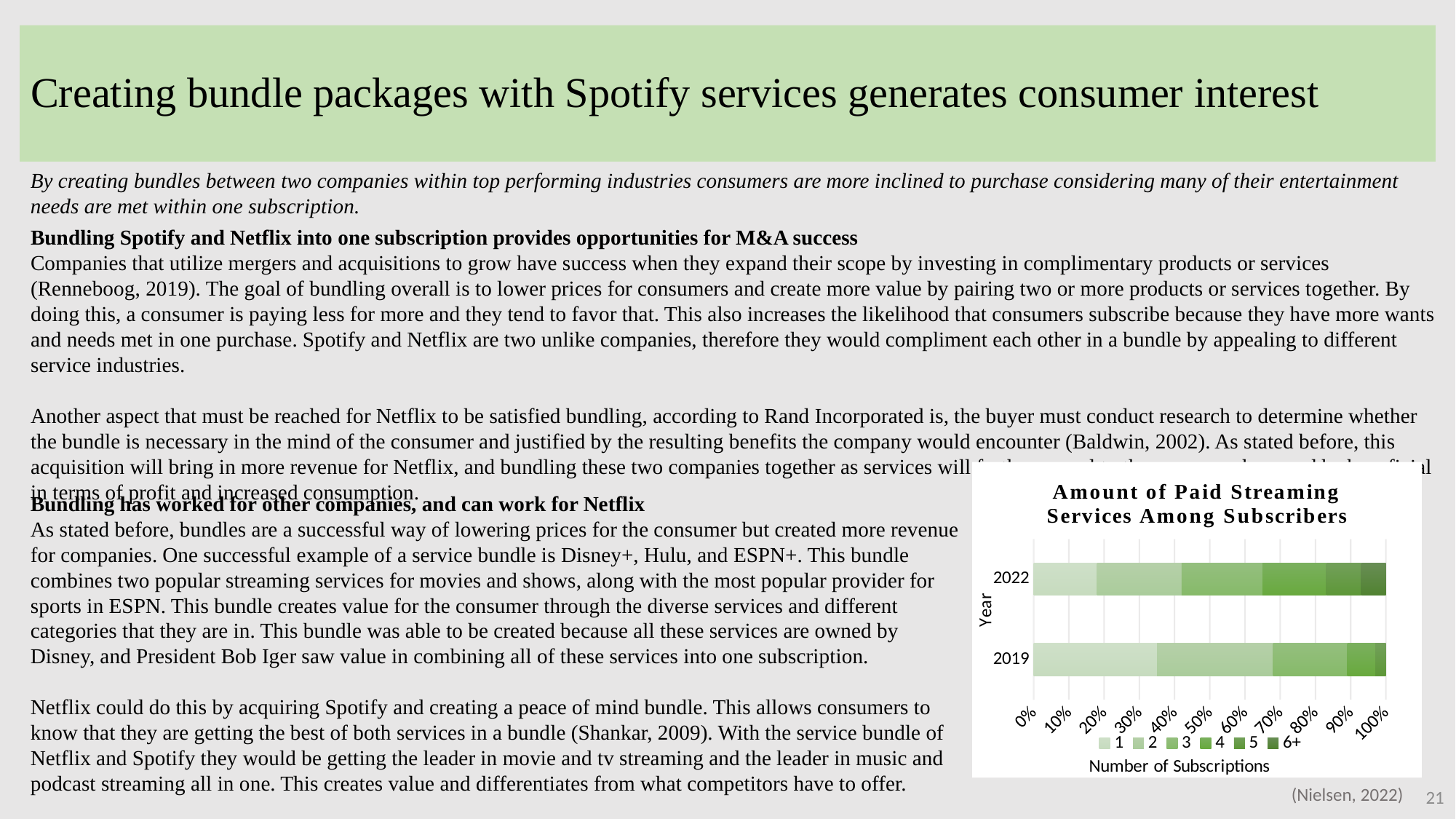
How many series does the chart's legend list? 6 How many years are plotted on the chart? 2 Which year has the larger share of subscribers with only 1 paid streaming subscription? 2019 Is the share of subscribers with 6+ subscriptions in 2022 greater or less than 10%? less Which years are shown on the chart's y axis? 2022 and 2019 Which year has the larger share of subscribers with 2 subscriptions? 2019 Is the share of subscribers with 1 subscription in 2019 greater or less than 30%? greater What kind of chart is shown on the slide? Stacked bar chart Does the share of subscribers with only 1 subscription rise or fall from 2019 to 2022? fall Is the share of subscribers with 1 subscription in 2022 greater or less than 30%? less Which year shows segments for 5 and 6+ subscriptions? 2022 What is the title of the chart? Amount of Paid Streaming Services Among Subscribers